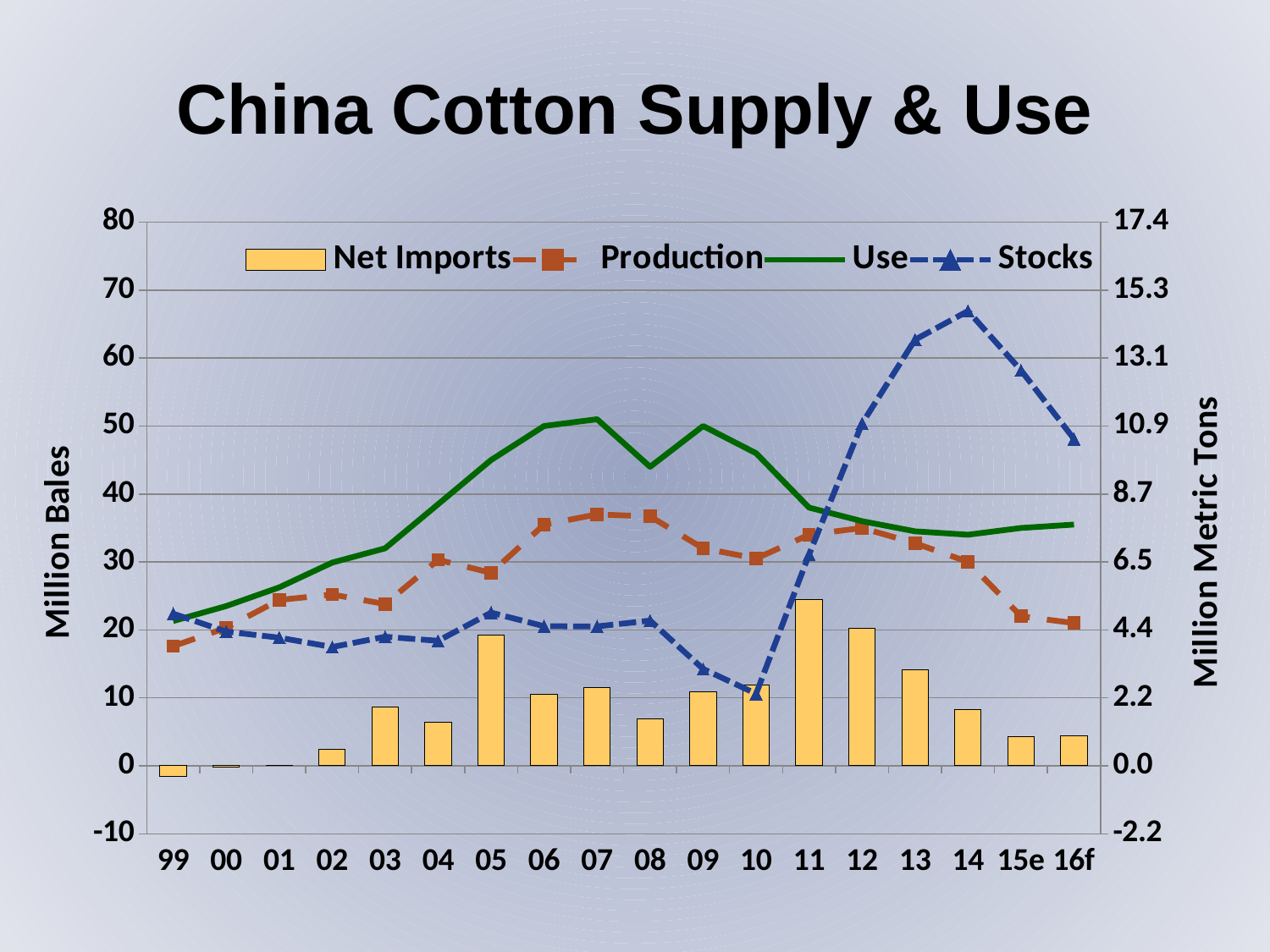
In which year are Stocks highest? 14 Is the Use value for 05 greater or less than 40? greater How many series does the legend list? 4 Do Stocks rise or fall from 10 to 14? Rise In which year are Net Imports highest? 11 In which year are Stocks lowest? 10 Which is larger in 07, Use or Production? Use Is the Net Imports value for 99 greater or less than 0? less Is the Net Imports value for 11 greater or less than 20? greater How many years are shown along the x axis? 18 What is the label of the left vertical axis? Million Bales What kind of chart is shown on the slide? A combination bar and line chart